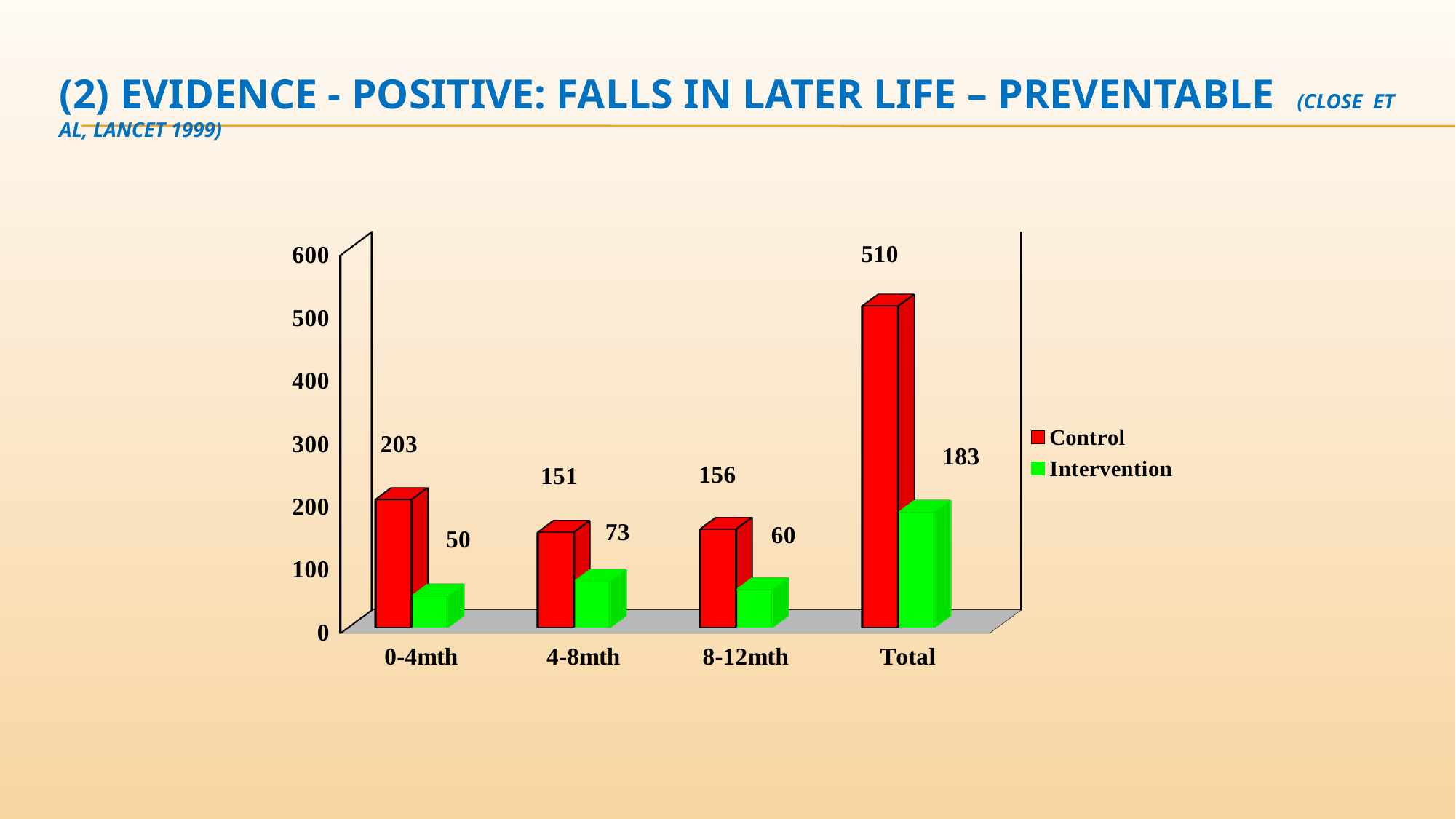
What kind of chart is shown on the slide? Bar chart How many categories are shown on the x axis? 4 Among the three time periods (excluding Total), which has the highest Control value? 0-4mth Which is larger, the Intervention value for 4-8mth or for 8-12mth? 4-8mth What is the Control value for Total? 510 Which category has the lowest Intervention value? 0-4mth What is the difference between the Control and Intervention values for Total? 327 What is the difference between the Control values for 8-12mth and 4-8mth? 5 What is the Intervention value for 8-12mth? 60 What is the Control value for 0-4mth? 203 How many series does the legend list? 2 What is the Intervention value for 4-8mth? 73